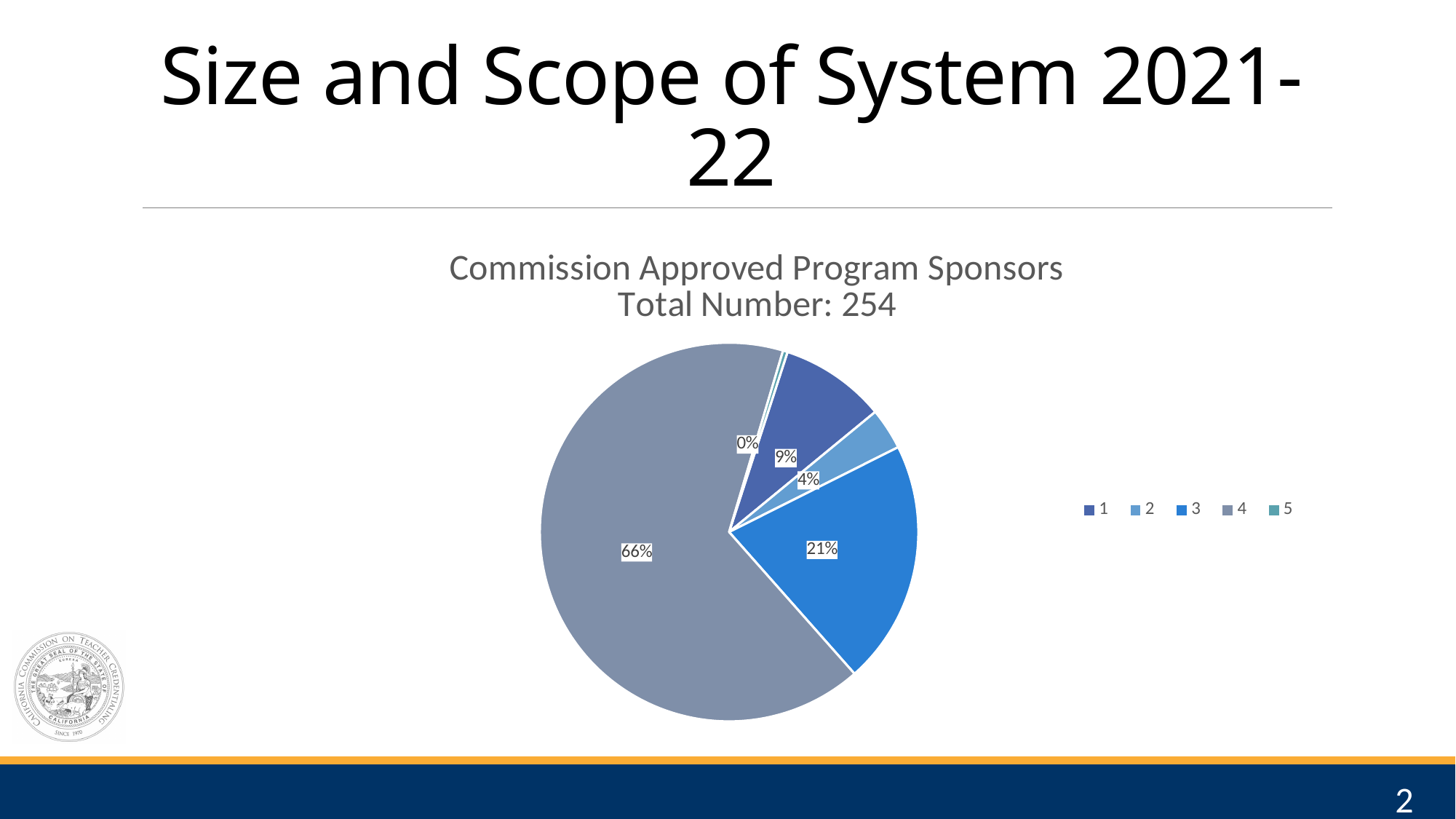
What share of the pie does category 1 represent? 9% How many slices does the pie chart have? 5 Which category has the largest slice of the pie? 4 What share of the pie does category 5 represent? 0% What share of the pie does category 3 represent? 21% What kind of chart is shown on the slide? pie chart What is the title of the chart? Commission Approved Program Sponsors Total Number: 254 What is the difference between the shares of category 4 and category 3? 45% How many entries does the legend list? 5 Which category has the smallest slice of the pie? 5